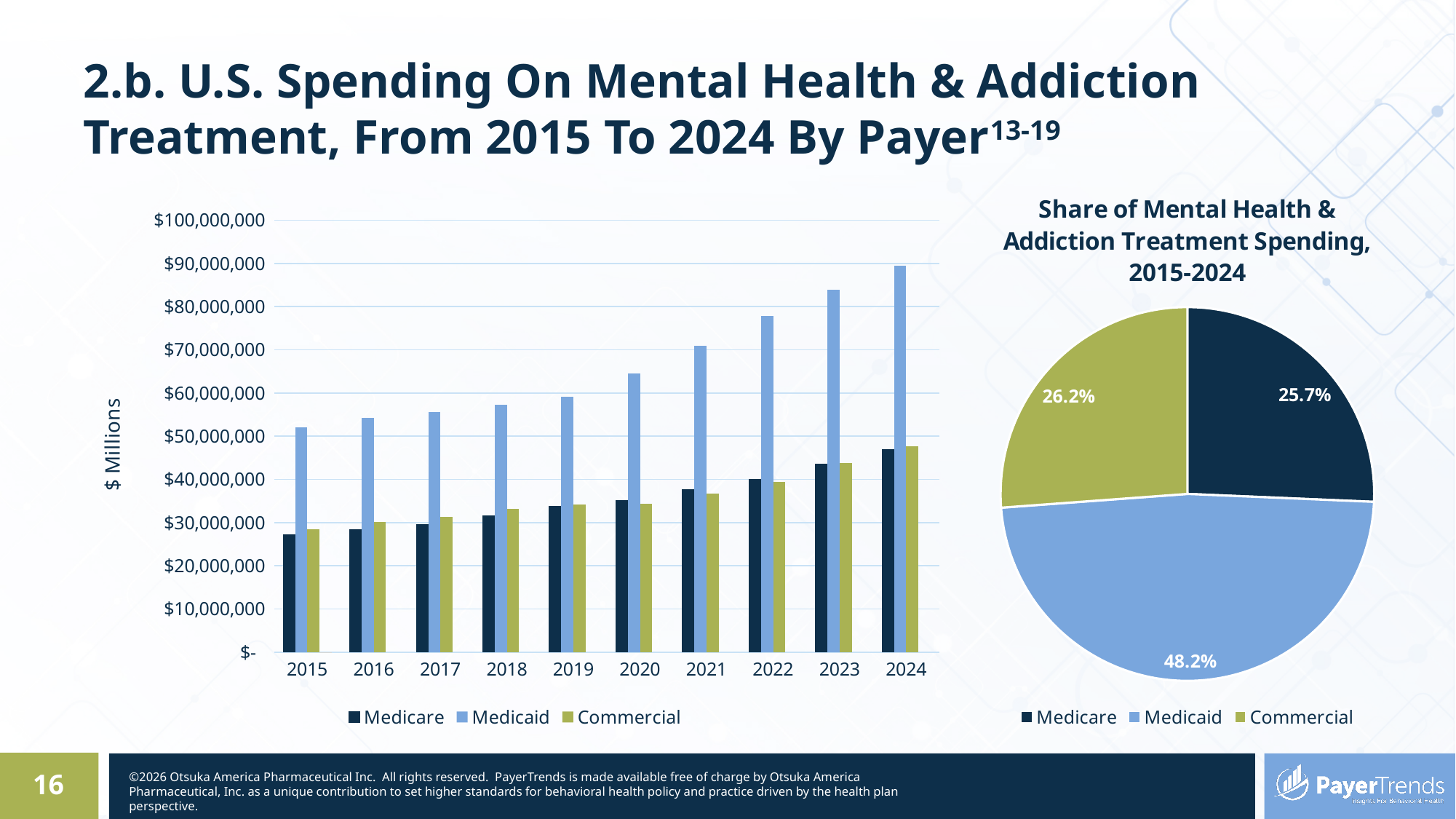
In the pie chart on the right, which payer has the largest share? Medicaid In the bar chart on the left, which payer has the tallest bar in 2024? Medicaid In the bar chart on the left, does Medicaid spending rise or fall from 2015 to 2024? Rise In the bar chart on the left, is the Medicaid value for 2024 greater or less than $80,000,000? greater In the pie chart on the right, what share does Medicare have? 25.7% In the pie chart on the right, what is the difference between the Medicaid share and the Medicare share? 22.5% In the pie chart on the right, what share does Commercial have? 26.2% In the bar chart on the left, is the Medicare value for 2015 greater or less than $30,000,000? less What kind of chart is on the left side of the slide? Bar chart In the pie chart titled 'Share of Mental Health & Addiction Treatment Spending, 2015-2024', what share does Medicaid have? 48.2% In the bar chart on the left, how many series does the legend list? 3 In the bar chart on the left, how many years are shown on the x axis? 10